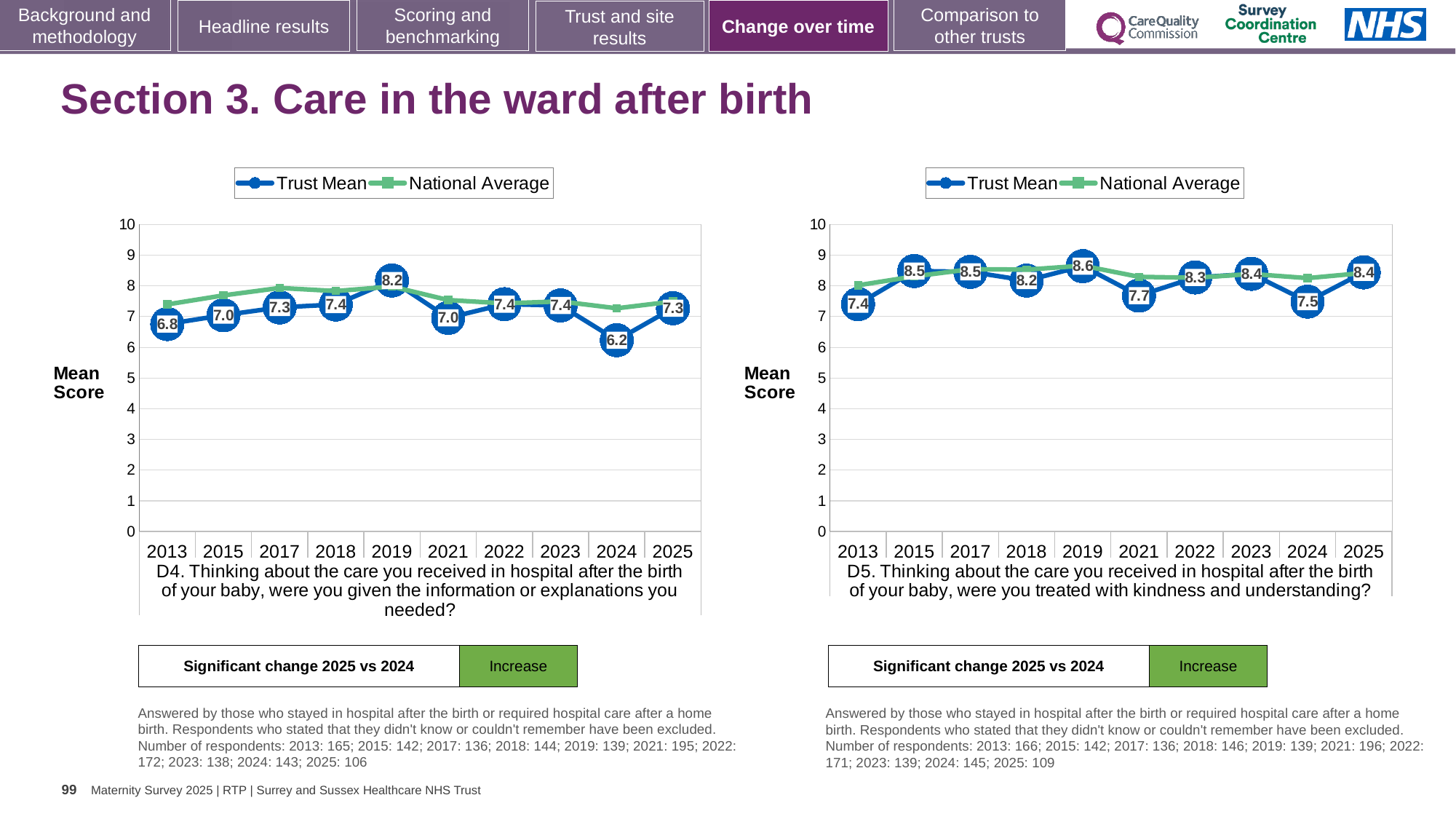
In the D4 chart on the left, which year has the lowest Trust Mean? 2024 In the D4 chart on the left, which year has the highest Trust Mean? 2019 In the D5 chart on the right, what is the difference between the Trust Mean for 2019 and 2013? 1.2 In the D4 chart on the left, what is the difference between the Trust Mean for 2025 and 2024? 1.1 In the D5 chart on the right, which year has the highest Trust Mean? 2019 In the D4 chart on the left, what is the Trust Mean for 2024? 6.2 In the D5 chart on the right, is the Trust Mean for 2021 or 2022 larger? 2022 In the D4 chart on the left, is the National Average for 2013 greater or less than 7? greater In the D4 chart on the left, what is the Trust Mean for 2019? 8.2 How many series does the legend of the D4 chart on the left list? 2 How many years are plotted on the x axis of the D5 chart on the right? 10 In the D5 chart on the right, what is the Trust Mean for 2013? 7.4